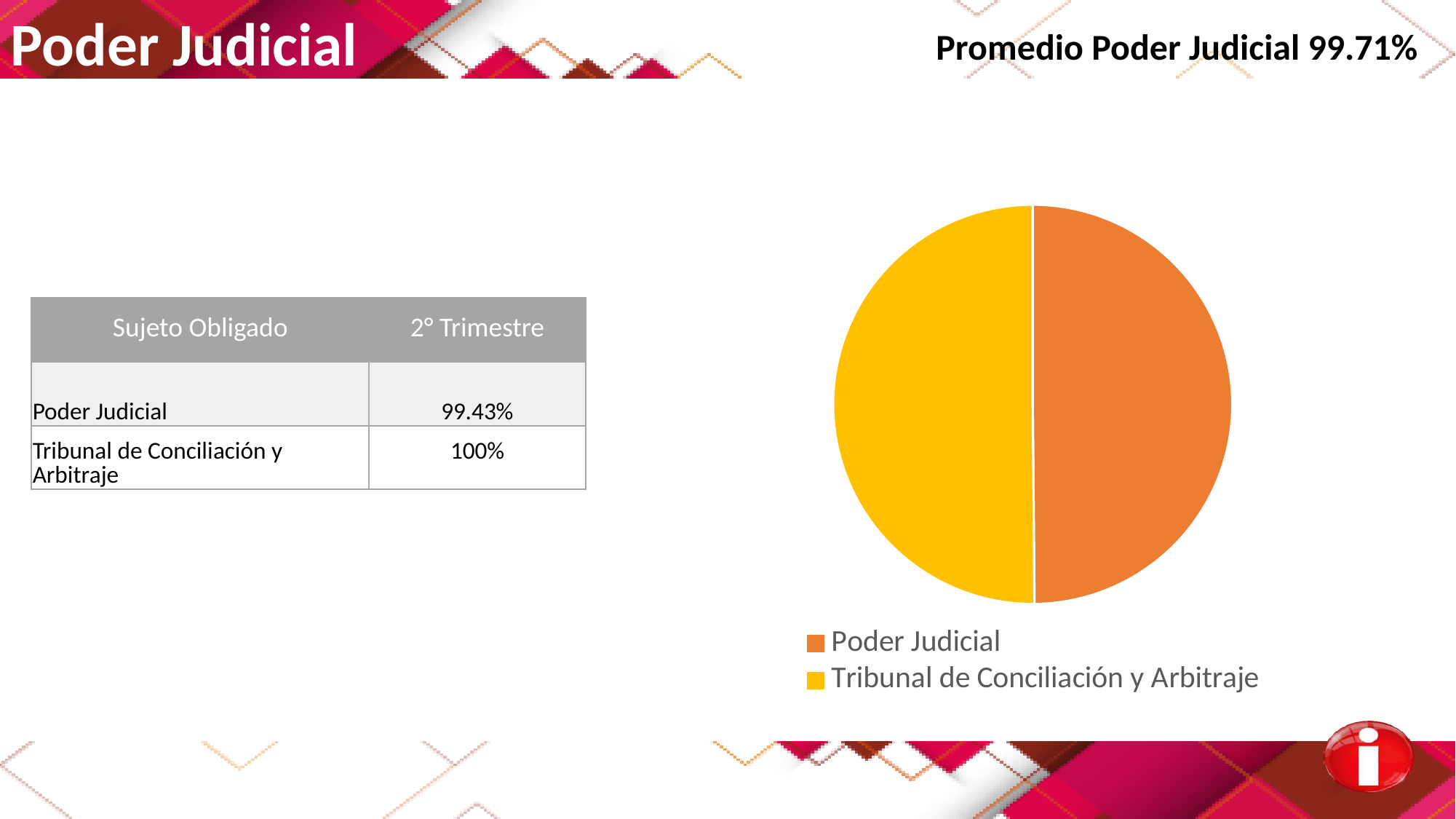
How many entries does the legend of the pie chart list? 2 According to the table on the slide, what is the 2° Trimestre value for Poder Judicial? 99.43% Which colour represents Poder Judicial in the pie chart? orange According to the table on the slide, what is the 2° Trimestre value for Tribunal de Conciliación y Arbitraje? 100% Based on the values printed in the table, which pie chart category has the lowest value? Poder Judicial Based on the values printed in the table, which of the two pie chart categories has the higher value: Poder Judicial or Tribunal de Conciliación y Arbitraje? Tribunal de Conciliación y Arbitraje What average value is stated in the heading at the top right of the slide? 99.71% Which colour represents Tribunal de Conciliación y Arbitraje in the pie chart? yellow How many slices does the pie chart have? 2 What kind of chart is shown on the slide? pie chart Based on the values printed in the table, what is the difference between the values for Tribunal de Conciliación y Arbitraje and Poder Judicial? 0.57%